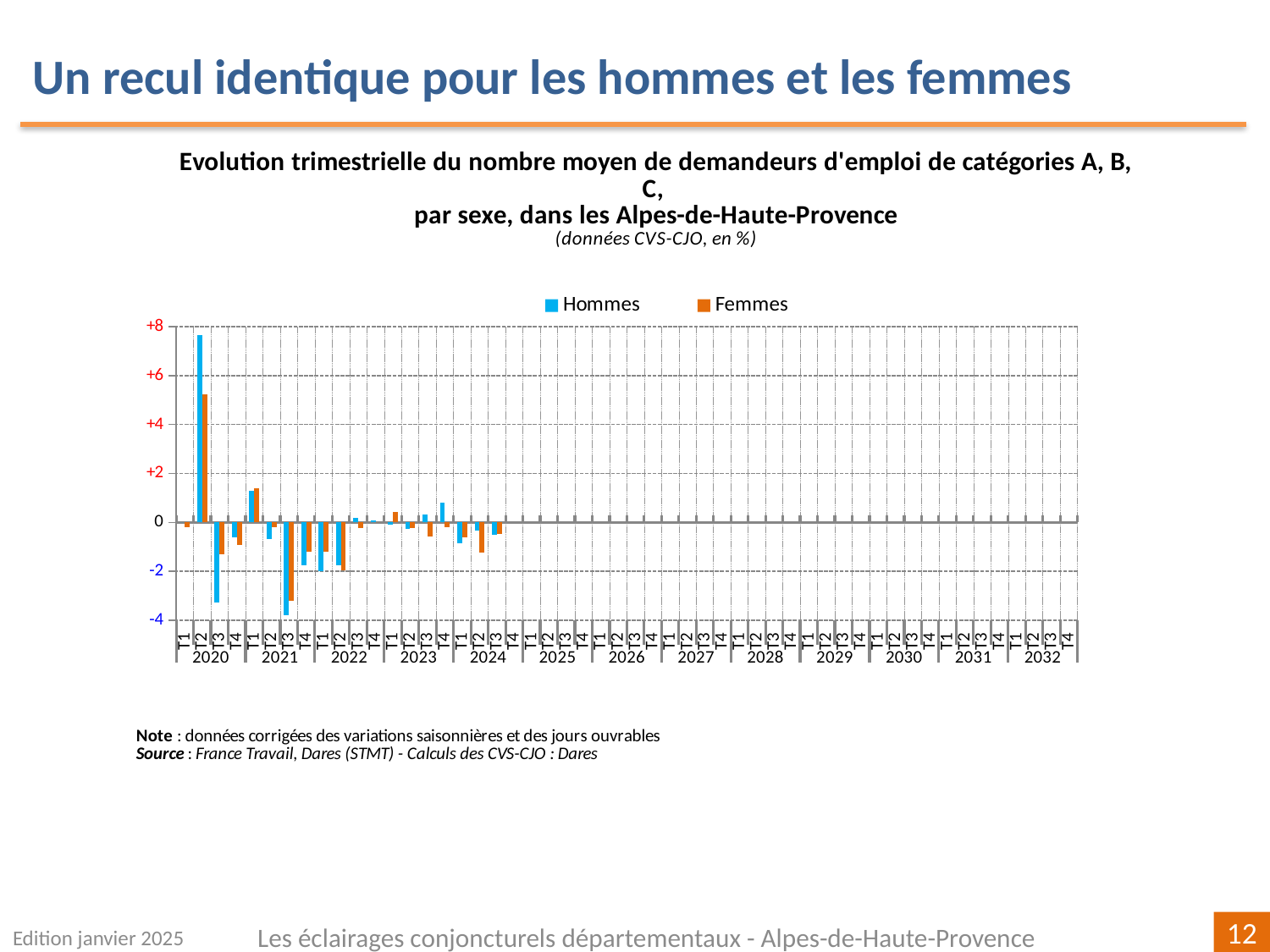
Is the Hommes value for T3 2020 greater or less than -2? less In T2 2020, which series has the larger value, Hommes or Femmes? Hommes Which colour represents the Femmes series? orange Is the Femmes value for T2 2020 greater or less than +4? greater In which quarter is the Hommes value highest? T2 2020 Is the Hommes value for T2 2020 greater or less than +6? greater In which quarter is the Femmes value lowest? T3 2021 How many years are labelled along the x axis? 13 What are the two series named in the legend? Hommes and Femmes How many series does the legend list? 2 What kind of chart is shown on the slide? bar chart